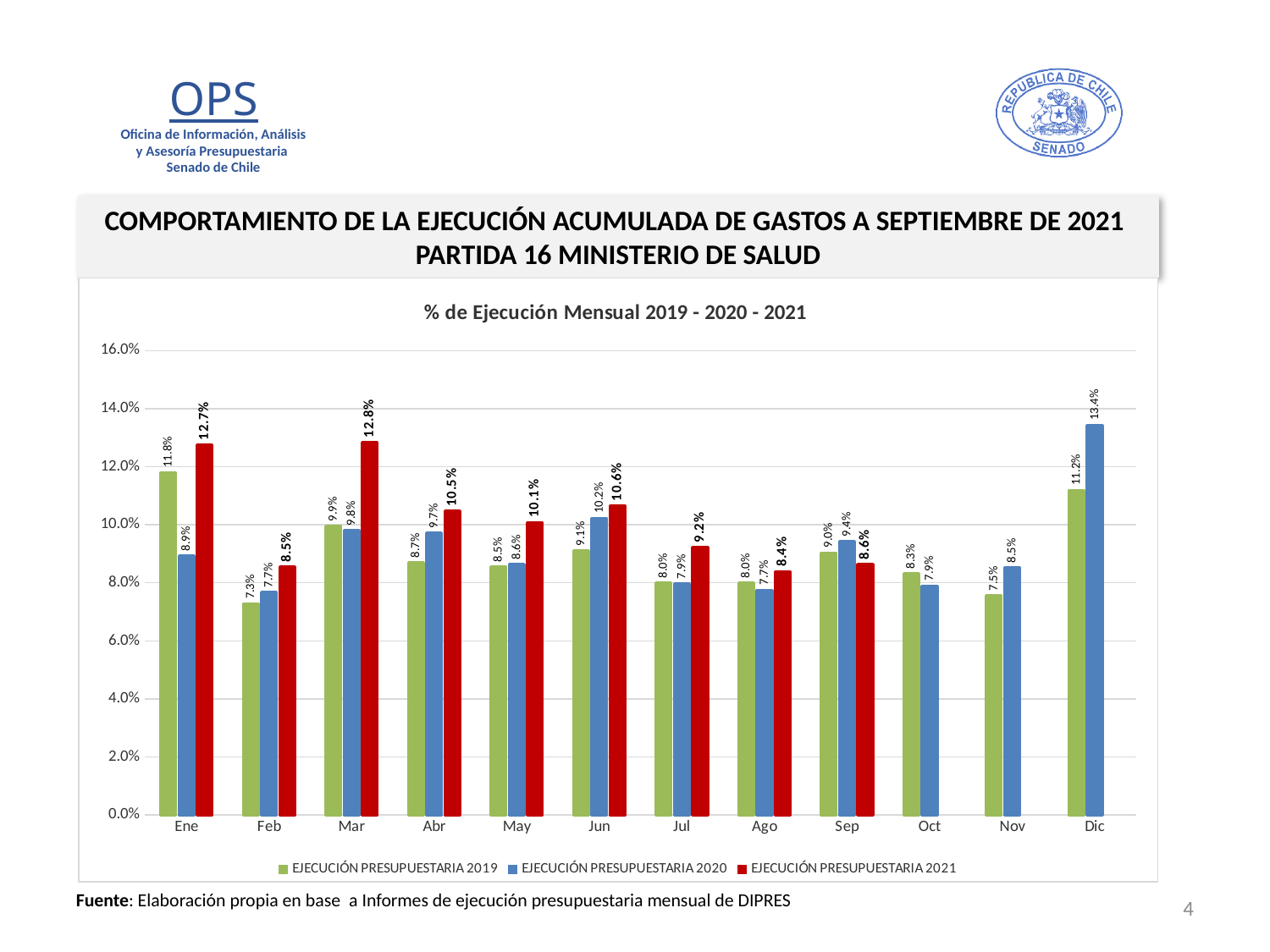
What is the value for EJECUCIÓN PRESUPUESTARIA 2019 in Ene? 11.8% How many series does the legend list? 3 How many months are shown on the x axis? 12 Which month has the highest value for EJECUCIÓN PRESUPUESTARIA 2021? Mar What kind of chart is shown on the slide? Bar chart Is the value for EJECUCIÓN PRESUPUESTARIA 2020 in Nov greater or less than 10.0%? less What is the difference between the EJECUCIÓN PRESUPUESTARIA 2021 and EJECUCIÓN PRESUPUESTARIA 2019 values in Ene? 0.9% What is the value for EJECUCIÓN PRESUPUESTARIA 2020 in Dic? 13.4% What is the title of the chart? % de Ejecución Mensual 2019 - 2020 - 2021 What is the value for EJECUCIÓN PRESUPUESTARIA 2021 in Mar? 12.8% In Sep, which series has the larger value: EJECUCIÓN PRESUPUESTARIA 2020 or EJECUCIÓN PRESUPUESTARIA 2021? EJECUCIÓN PRESUPUESTARIA 2020 Which month has the lowest value for EJECUCIÓN PRESUPUESTARIA 2019? Feb